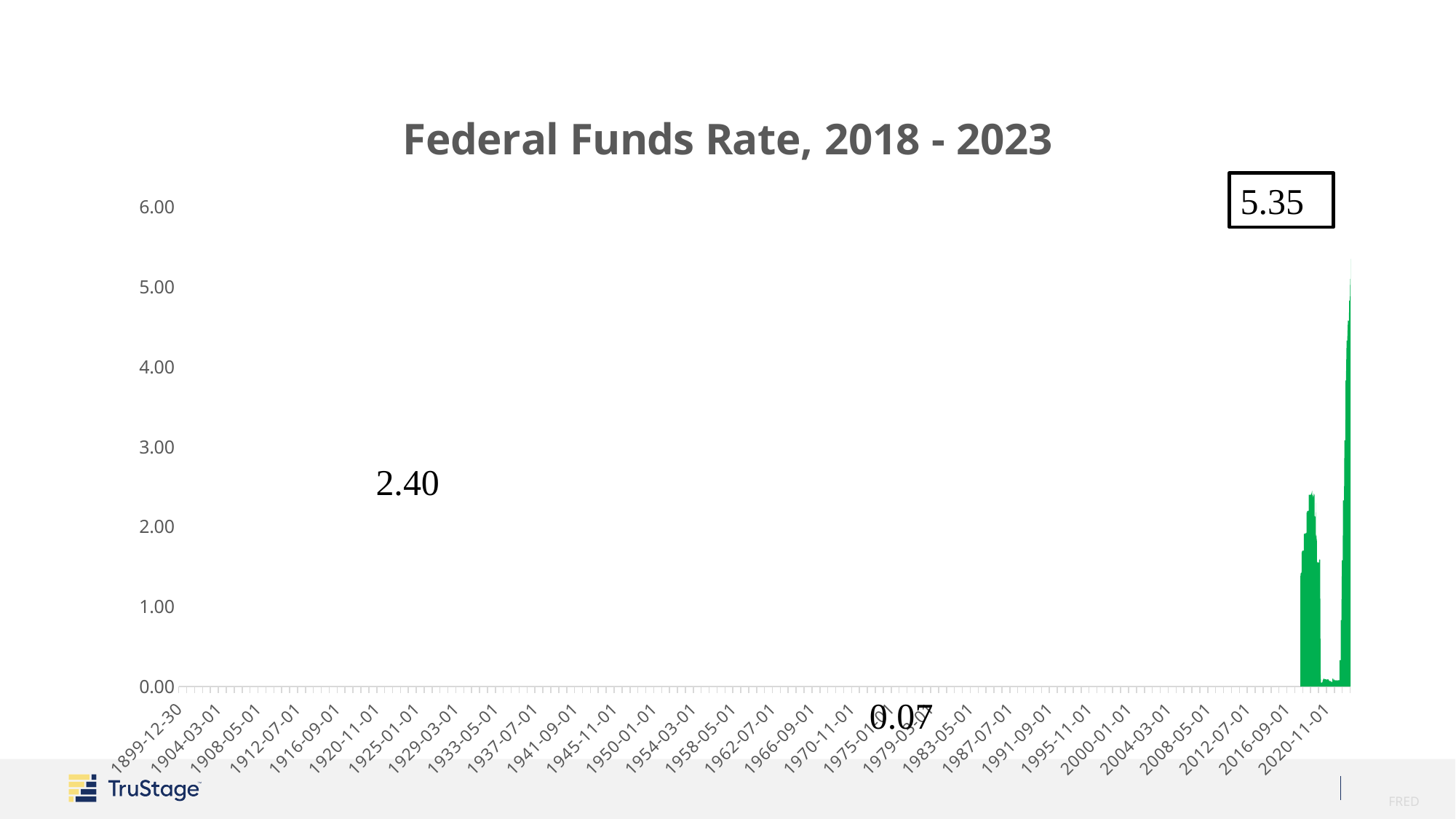
What is the highest value annotated on the chart? 5.35 What is the title of the chart? Federal Funds Rate, 2018 - 2023 What value is shown in the boxed label at the top right of the chart? 5.35 Which annotated value is larger, 2.40 or 5.35? 5.35 What is the lowest value annotated on the chart? 0.07 What is the highest tick value shown on the y axis? 6.00 What is the first date label shown on the x axis? 1899-12-30 Is the peak of the plotted data at the far right greater or less than 6.00? less Is the peak of the plotted data at the far right greater or less than 5.00? greater Do the plotted values rise or fall at the far right end of the chart? rise What is the difference between the annotated values 5.35 and 0.07? 5.28 What is the difference between the annotated values 5.35 and 2.40? 2.95